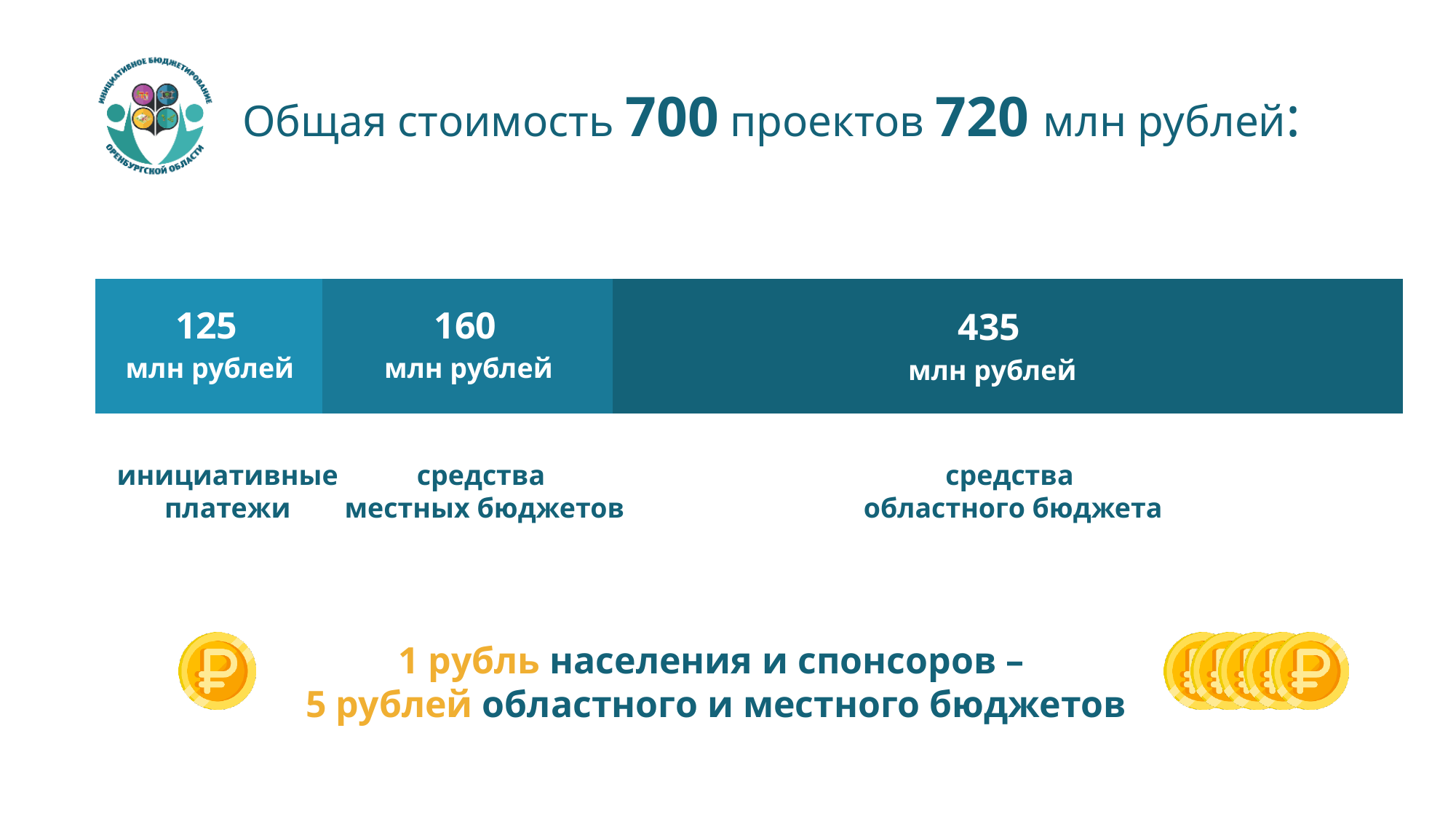
What is the value for средства местных бюджетов? 160 млн рублей What is the title of the chart? Общая стоимость 700 проектов 720 млн рублей Which segment of the bar is the smallest? инициативные платежи Which segment of the bar is the largest? средства областного бюджета What is the value for инициативные платежи? 125 млн рублей What kind of chart is shown on the slide? stacked bar chart What is the difference between средства областного бюджета and средства местных бюджетов? 275 млн рублей What is the difference between средства местных бюджетов and инициативные платежи? 35 млн рублей What is the value for средства областного бюджета? 435 млн рублей How many segments make up the stacked bar? 3 Which is larger, средства местных бюджетов or инициативные платежи? средства местных бюджетов What is the total of all segments in the stacked bar? 720 млн рублей